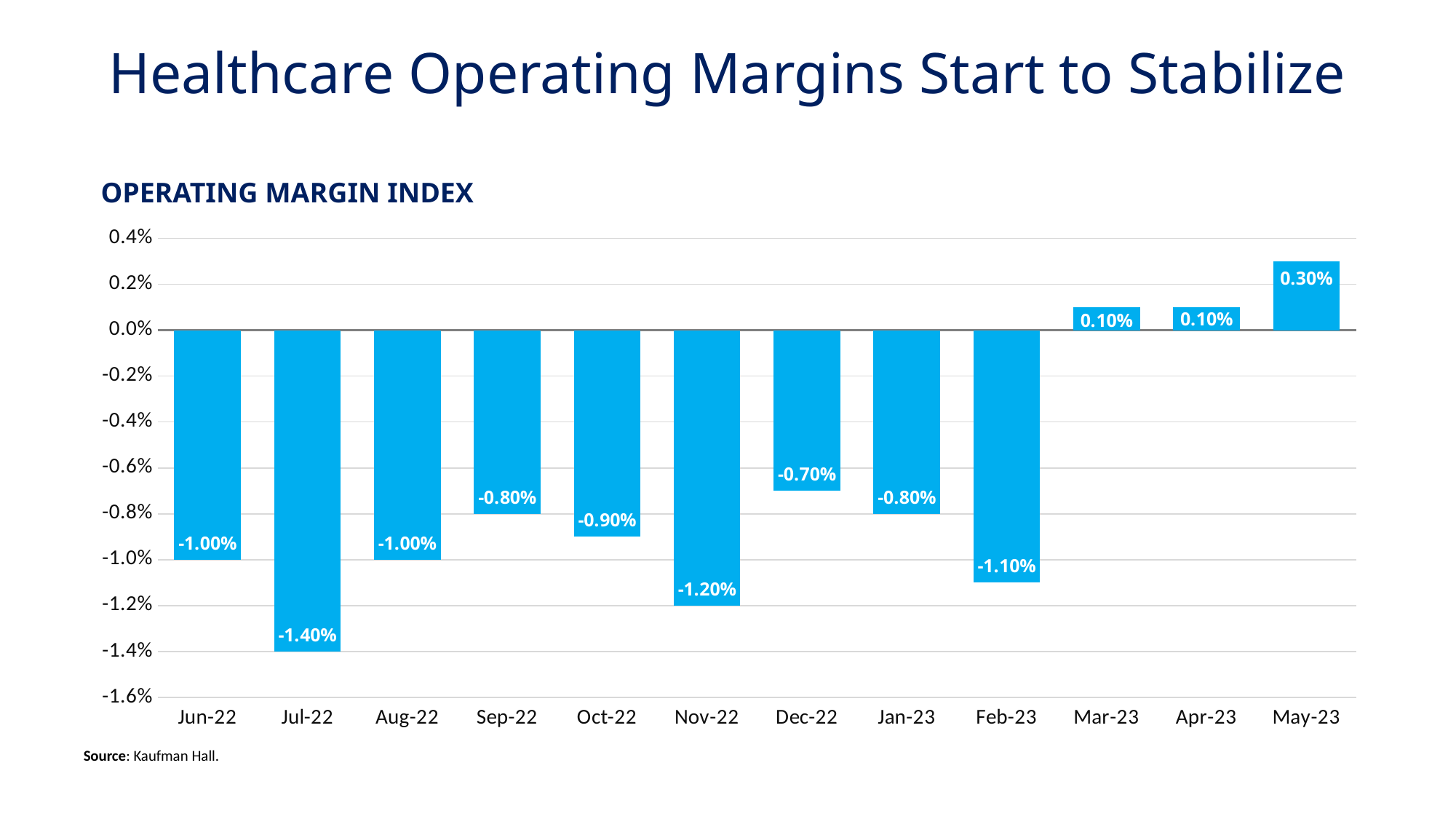
Do the operating margin index values generally rise or fall from Feb-23 to May-23? Rise Which month has the lowest operating margin index value? Jul-22 What is the title of the chart on the slide? OPERATING MARGIN INDEX Which is larger, the operating margin index value for Sep-22 or Oct-22? Sep-22 What kind of chart is shown on the slide? Bar chart What is the difference between the operating margin index values for May-23 and Jul-22? 1.70% How many months are shown on the x axis of the chart? 12 What is the operating margin index value for May-23? 0.30% What is the operating margin index value for Jul-22? -1.40% What is the operating margin index value for Dec-22? -0.70% Which month has the highest operating margin index value? May-23 What is the operating margin index value for Nov-22? -1.20%